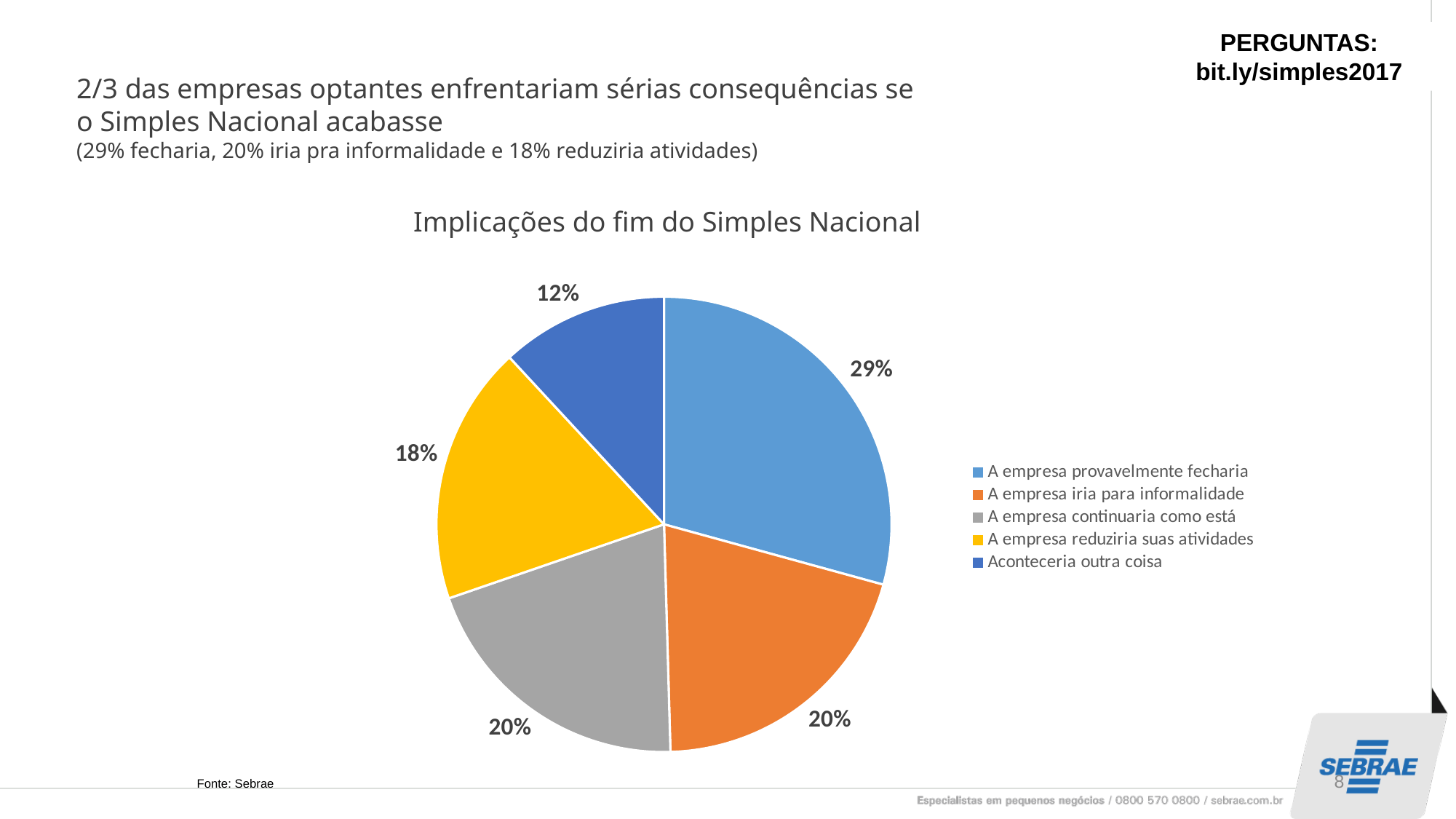
What colour is the slice for 'A empresa reduziria suas atividades'? yellow What share of the pie is 'A empresa provavelmente fecharia'? 29% Which category has the largest slice of the pie? A empresa provavelmente fecharia What is the difference between the share for 'A empresa provavelmente fecharia' and the share for 'Aconteceria outra coisa'? 17% How many categories does the pie chart have? 5 Which category has the smallest slice of the pie? Aconteceria outra coisa What share of the pie is 'A empresa iria para informalidade'? 20% What is the title of the chart? Implicações do fim do Simples Nacional Which is larger: the share for 'A empresa reduziria suas atividades' or the share for 'Aconteceria outra coisa'? A empresa reduziria suas atividades What share of the pie is 'Aconteceria outra coisa'? 12% What kind of chart is shown on the slide? pie chart